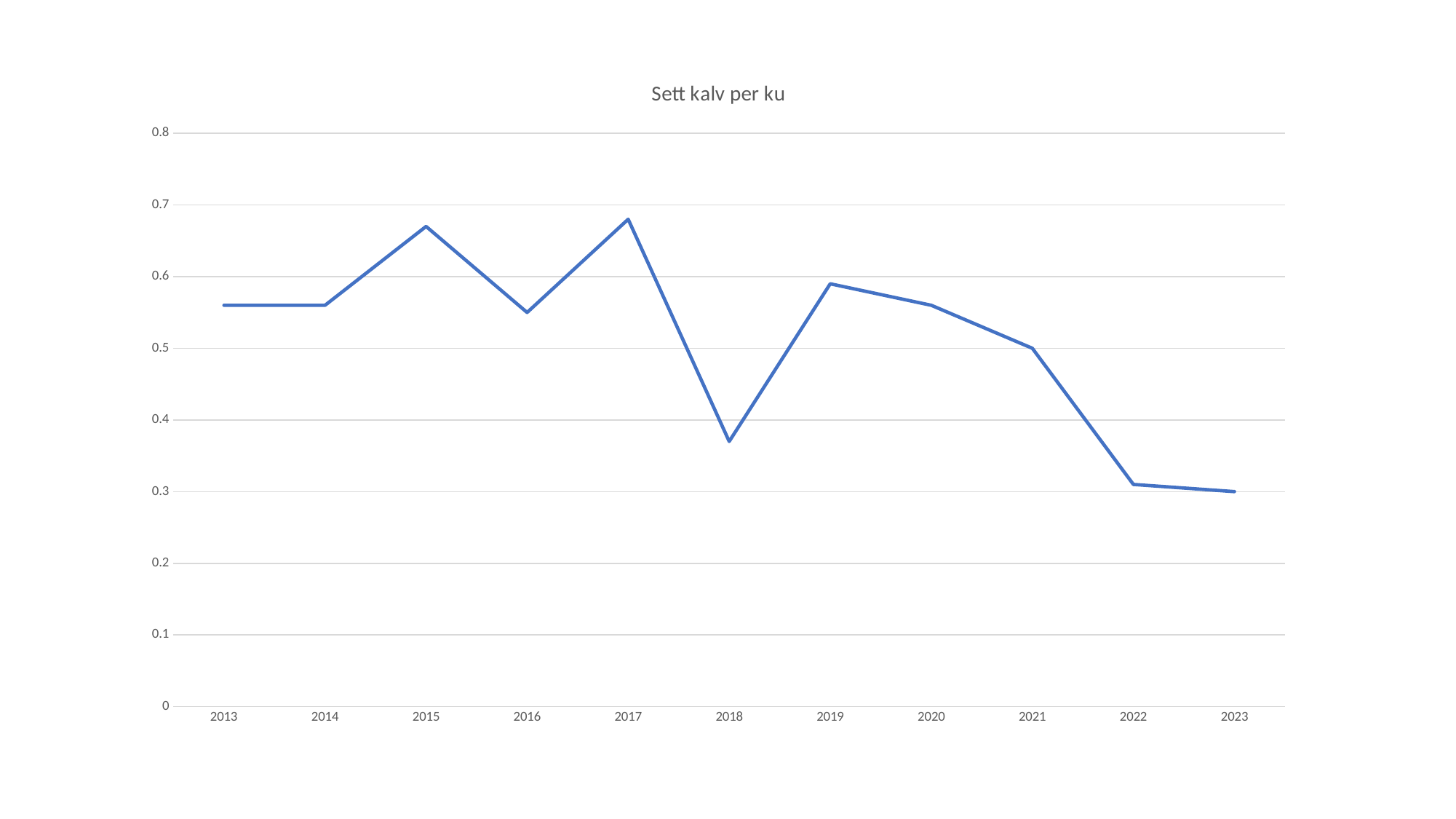
Is the value for 2013 greater or less than 0.5? greater Is the value for 2017 greater or less than 0.6? greater What is the title of the chart? Sett kalv per ku What kind of chart is shown on the slide? line chart Overall, do the values rise or fall from 2013 to 2023? fall Is the value for 2018 greater or less than 0.4? less What is the value for 2023? 0.3 What is the value for 2021? 0.5 Which year has the larger value, 2017 or 2018? 2017 Which year has the larger value, 2021 or 2022? 2021 How many years are plotted along the x axis? 11